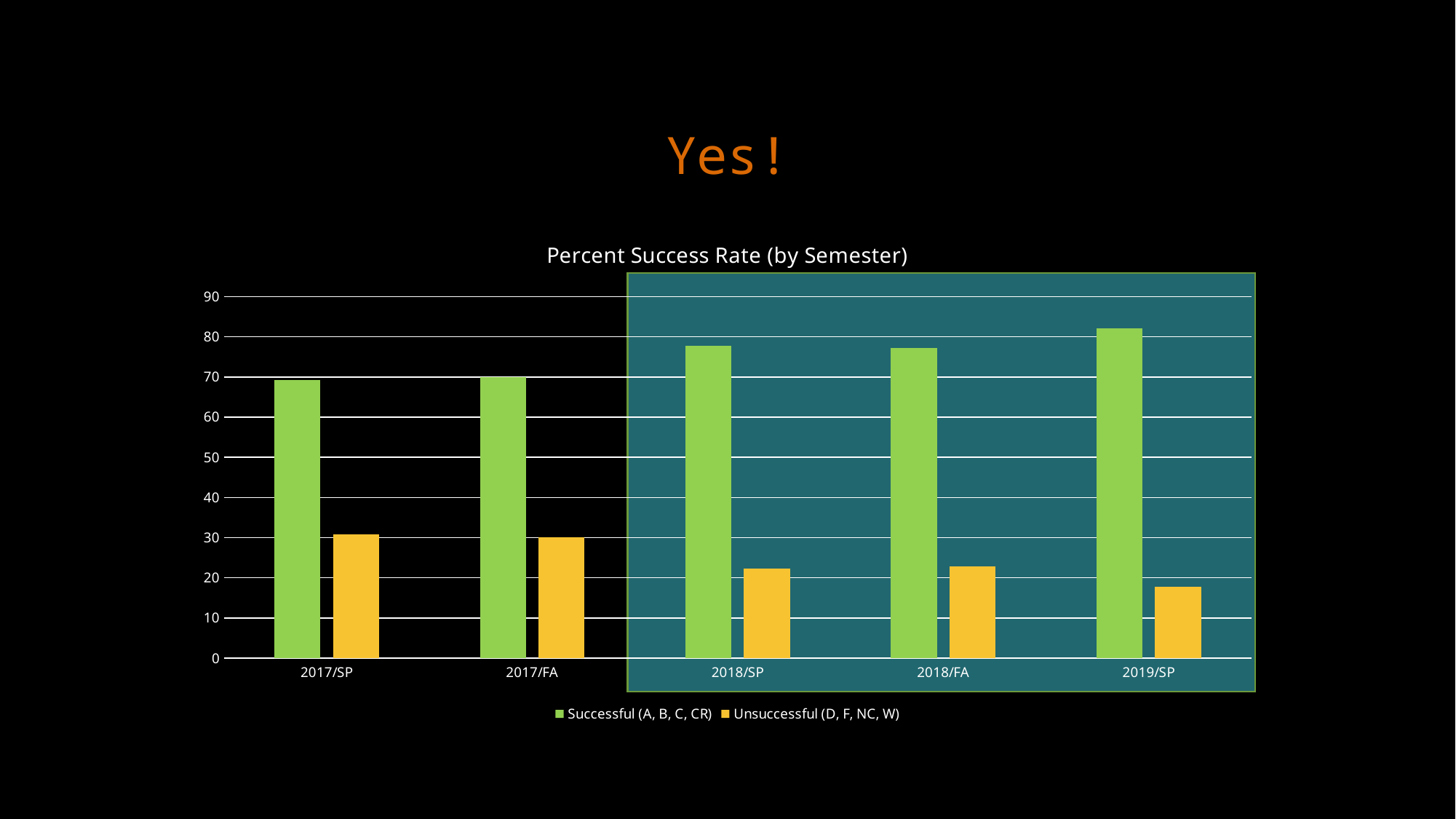
Is the Unsuccessful (D, F, NC, W) value for 2019/SP greater or less than 20? less How many series does the legend list? 2 What kind of chart is shown on the slide? bar chart Is the Successful (A, B, C, CR) value for 2019/SP greater or less than 80? greater Which semester has the lowest Unsuccessful (D, F, NC, W) value? 2019/SP Is the Successful (A, B, C, CR) value for 2018/FA greater or less than 70? greater Do the Unsuccessful (D, F, NC, W) values generally rise or fall from 2017/SP to 2019/SP? fall Which is larger: the Successful (A, B, C, CR) value for 2018/SP or for 2017/FA? 2018/SP Which semester has the highest Successful (A, B, C, CR) value? 2019/SP How many semesters are shown on the x axis? 5 What is the title of the chart? Percent Success Rate (by Semester)